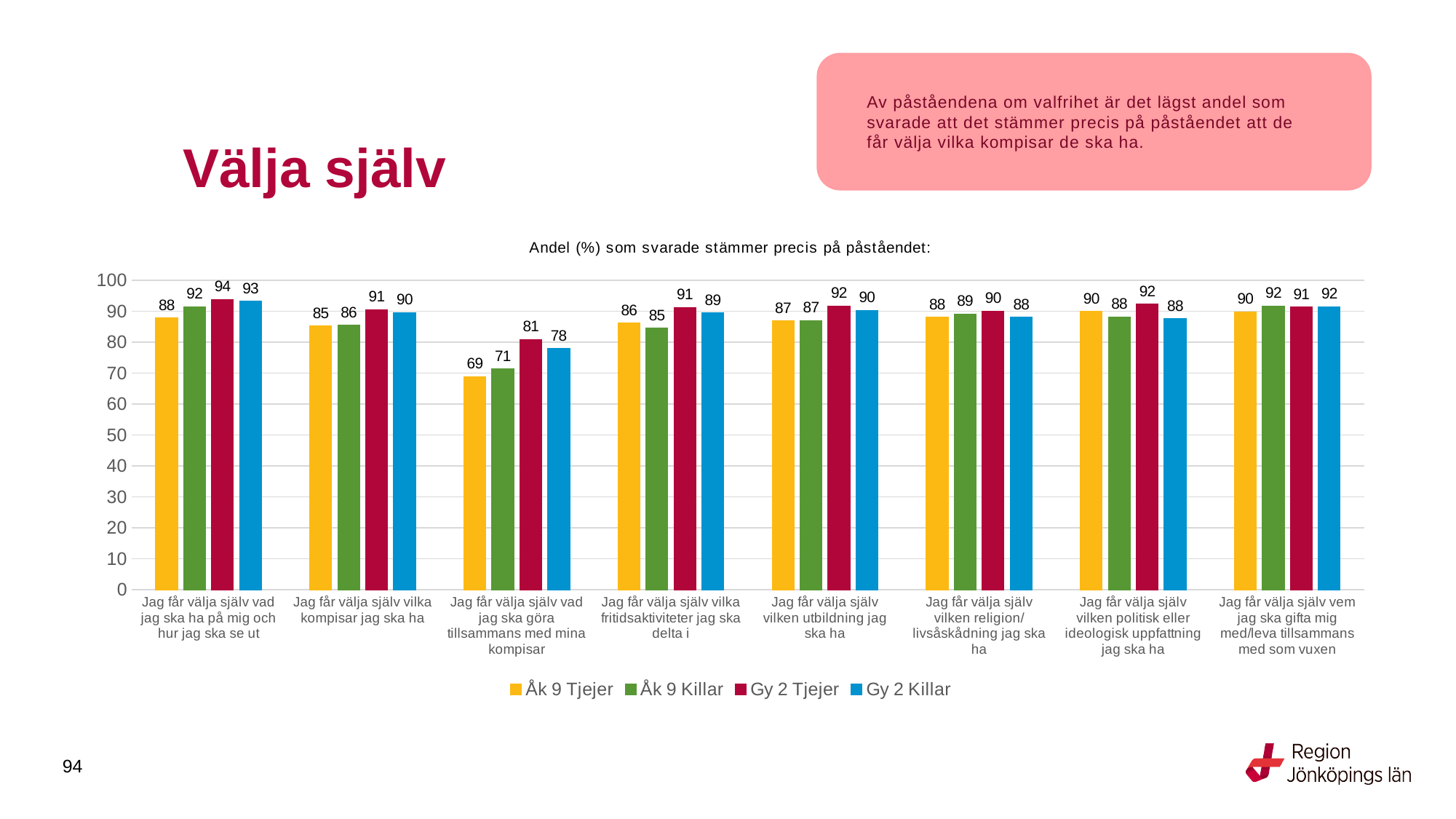
What is the difference between Gy 2 Tjejer and Åk 9 Tjejer on the statement "Jag får välja själv vad jag ska göra tillsammans med mina kompisar"? 12 Which statement has the lowest value for Gy 2 Killar? Jag får välja själv vad jag ska göra tillsammans med mina kompisar What kind of chart is shown on the slide? Bar chart Which colour represents Gy 2 Killar in the legend? Blue How many series does the legend list? 4 Which is larger on the statement "Jag får välja själv vilka fritidsaktiviteter jag ska delta i": Åk 9 Killar or Gy 2 Tjejer? Gy 2 Tjejer What is the value for Gy 2 Killar on the statement "Jag får välja själv vilka kompisar jag ska ha"? 90 Is the value for Åk 9 Killar on the statement "Jag får välja själv vad jag ska göra tillsammans med mina kompisar" greater or less than 80? less Which series has the highest value on the statement "Jag får välja själv vad jag ska ha på mig och hur jag ska se ut"? Gy 2 Tjejer How many statements (categories) are shown on the x axis? 8 What is the value for Åk 9 Tjejer on the statement "Jag får välja själv vad jag ska göra tillsammans med mina kompisar"? 69 What is the value for Gy 2 Tjejer on the statement "Jag får välja själv vad jag ska ha på mig och hur jag ska se ut"? 94